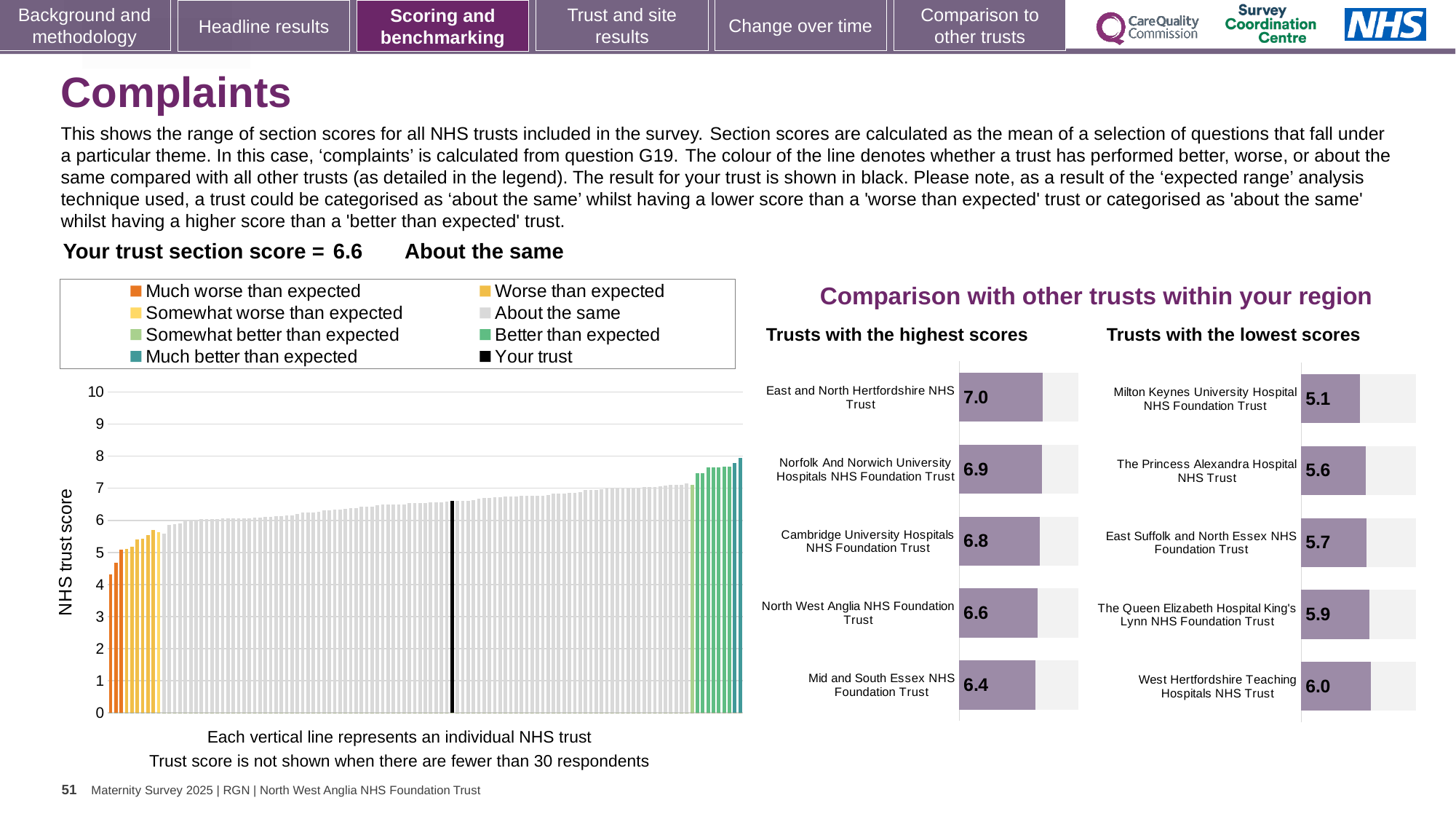
In the 'Trusts with the lowest scores' chart, which trust has the highest score? West Hertfordshire Teaching Hospitals NHS Trust In the 'Trusts with the highest scores' chart, what is the score for East and North Hertfordshire NHS Trust? 7.0 How many entries does the legend of the large 'NHS trust score' chart list? 8 In the 'Trusts with the highest scores' chart, what is the difference between the scores of East and North Hertfordshire NHS Trust and Mid and South Essex NHS Foundation Trust? 0.6 In the 'Trusts with the lowest scores' chart, what is the score for Milton Keynes University Hospital NHS Foundation Trust? 5.1 In the 'Trusts with the highest scores' chart, which trust has the lowest score? Mid and South Essex NHS Foundation Trust In the 'Trusts with the lowest scores' chart, which has the larger score: The Princess Alexandra Hospital NHS Trust or The Queen Elizabeth Hospital King's Lynn NHS Foundation Trust? The Queen Elizabeth Hospital King's Lynn NHS Foundation Trust How many trusts are listed in the 'Trusts with the lowest scores' chart? 5 In the 'Trusts with the highest scores' chart, what is the score for Mid and South Essex NHS Foundation Trust? 6.4 What kind of chart is the large 'NHS trust score' chart? bar chart In the large 'NHS trust score' chart, do the bar values rise or fall from left to right along the x axis? rise In the large 'NHS trust score' chart, what is the section score for your trust? 6.6